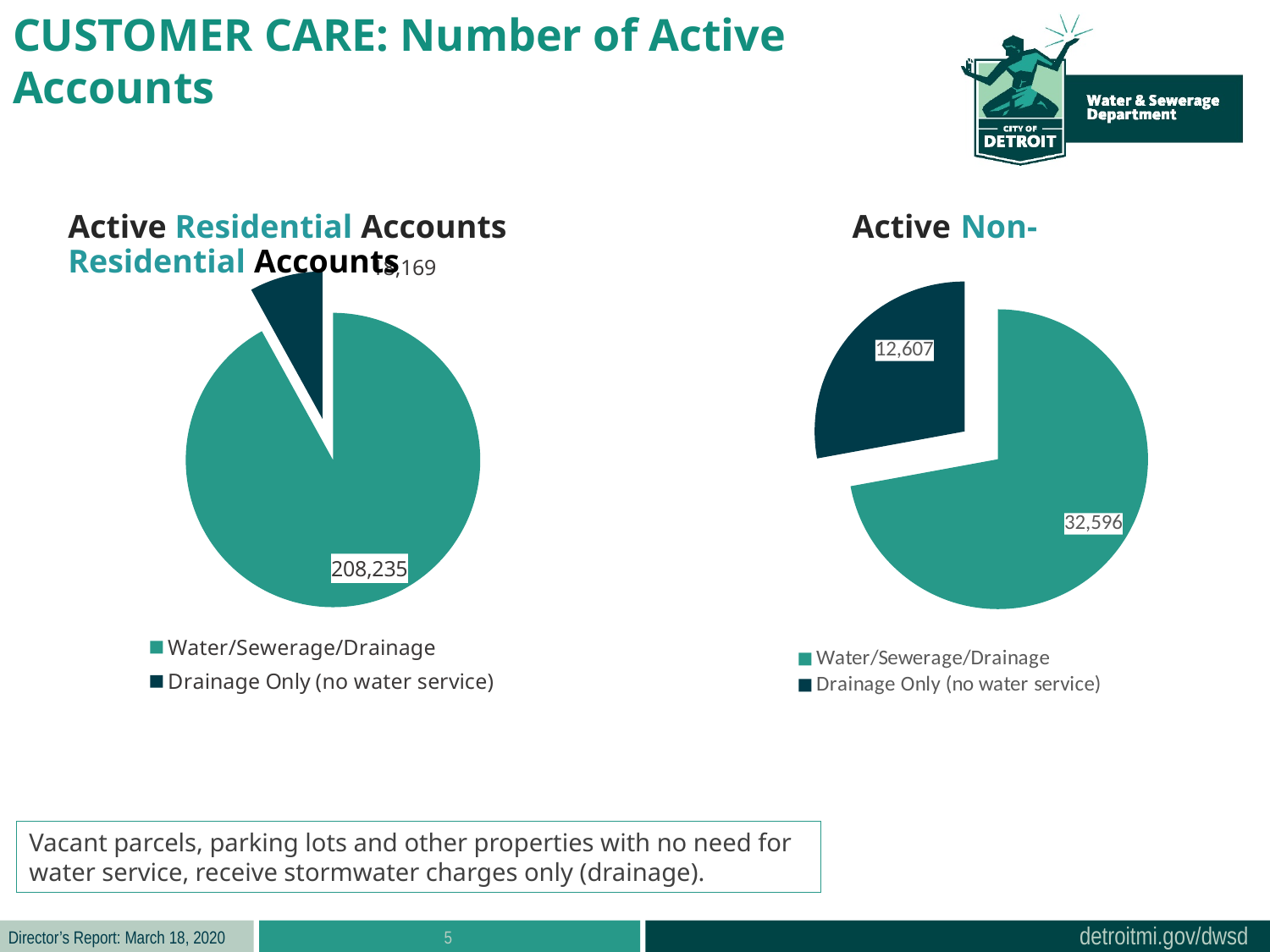
In the Active Non-Residential Accounts pie chart, how many Drainage Only (no water service) accounts are shown? 12,607 In the Active Non-Residential Accounts pie chart, what is the total number of accounts across both slices? 45,203 In the Active Residential Accounts pie chart, how many Water/Sewerage/Drainage accounts are shown? 208,235 How many slices does the Active Non-Residential Accounts pie chart have? 2 In the Active Non-Residential Accounts pie chart, how many Water/Sewerage/Drainage accounts are shown? 32,596 How many entries does the legend of the Active Residential Accounts chart list? 2 In the Active Non-Residential Accounts pie chart, which colour represents Drainage Only (no water service)? Dark teal (dark blue-green) In the Active Non-Residential Accounts pie chart, what is the difference between the Water/Sewerage/Drainage and Drainage Only (no water service) values? 19,989 In the Active Non-Residential Accounts pie chart, which is larger: Water/Sewerage/Drainage or Drainage Only (no water service)? Water/Sewerage/Drainage What type of chart is used for Active Residential Accounts? Pie chart In the Active Non-Residential Accounts pie chart, which category has the smallest slice? Drainage Only (no water service) In the Active Residential Accounts pie chart, which category has the largest slice? Water/Sewerage/Drainage